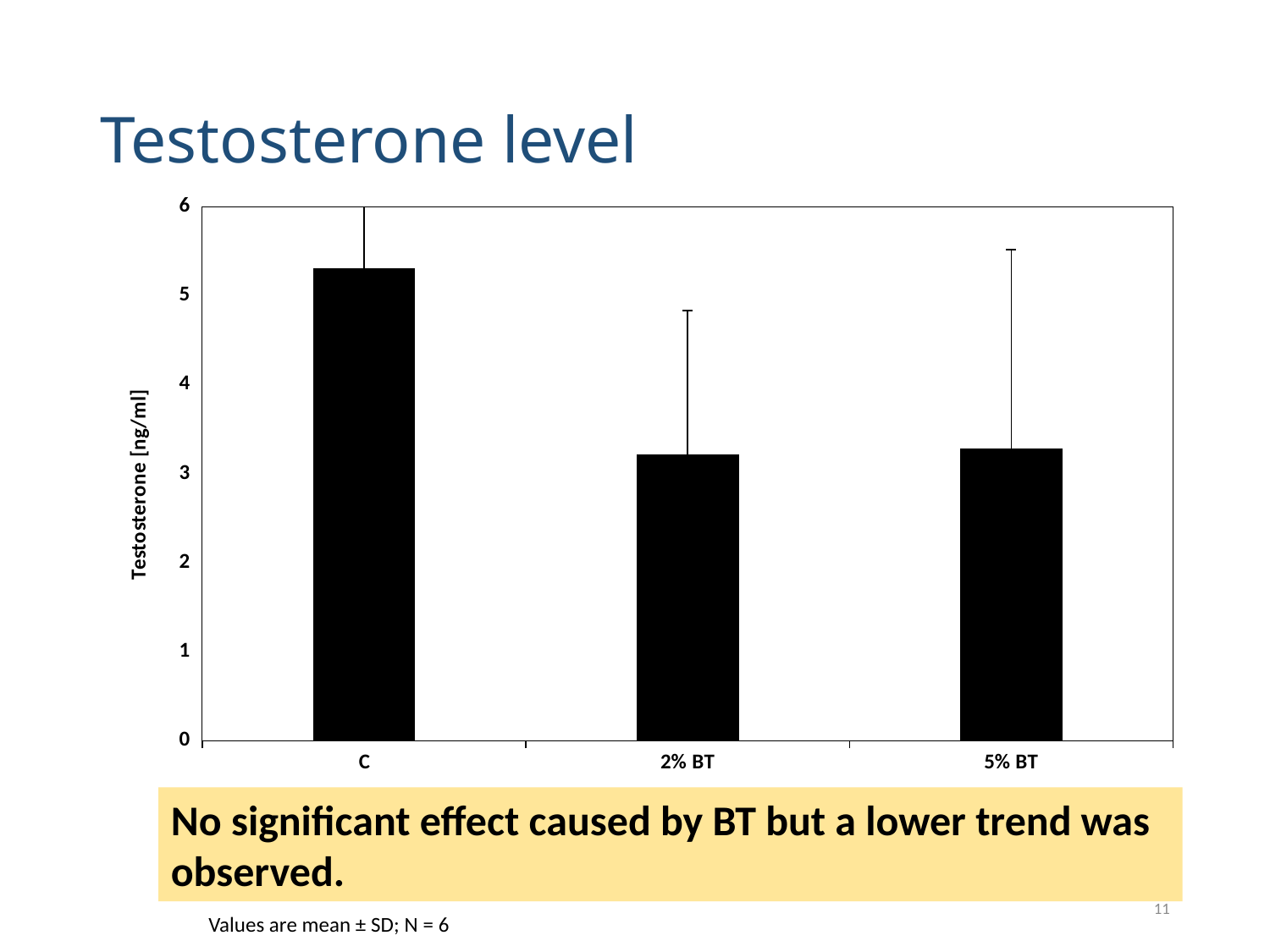
Is the value for C greater or less than 5? greater What kind of chart is shown on the slide? bar chart Is the value for C greater or less than 6? less Which is larger, the value for C or the value for 5% BT? C What is the label of the y axis of the chart? Testosterone [ng/ml] Which is larger, the value for C or the value for 2% BT? C Is the value for 5% BT greater or less than 4? less How many categories are shown on the x axis of the chart? 3 Which category has the highest testosterone level? C What is the highest tick value shown on the y axis? 6